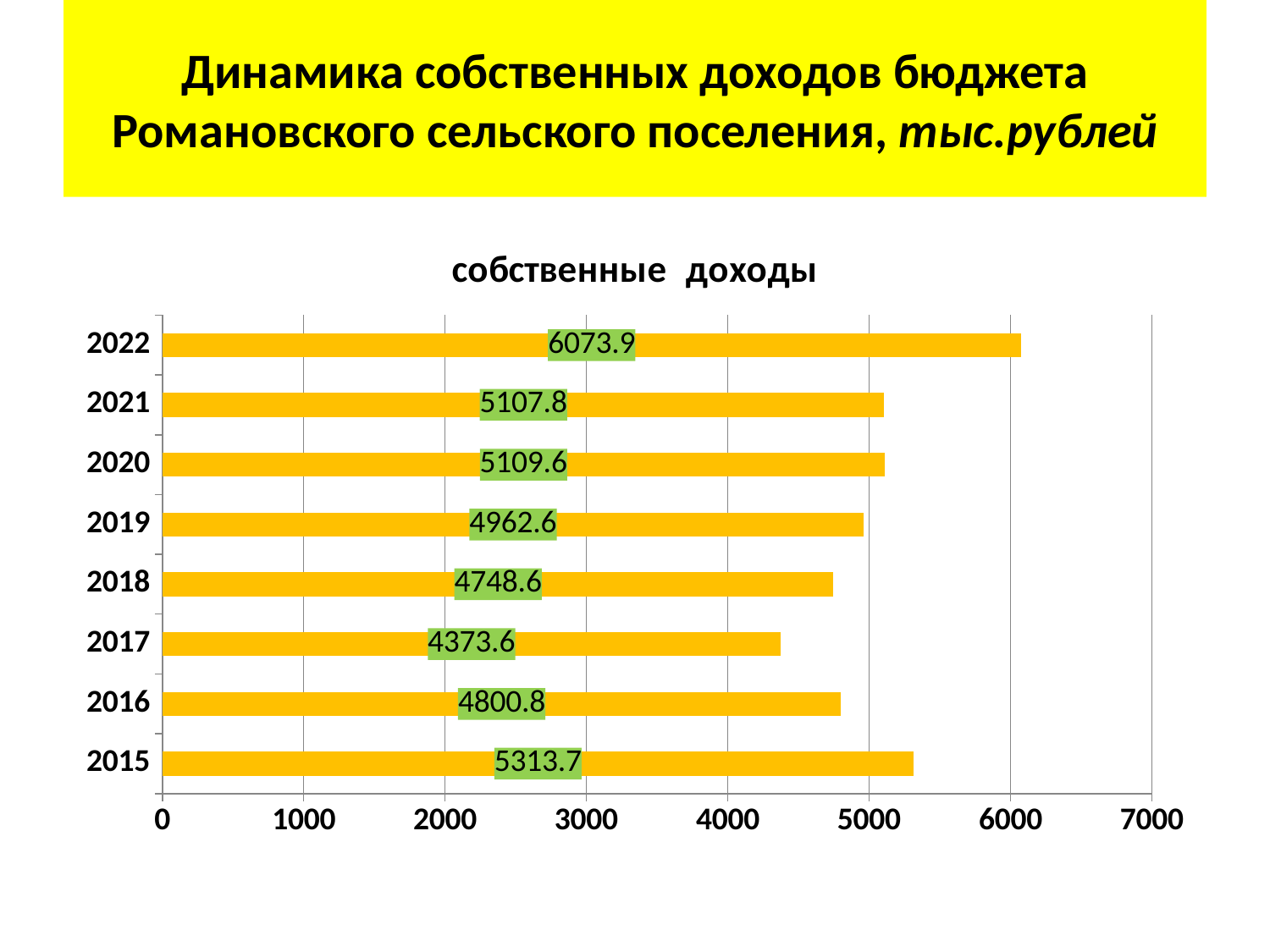
Which is larger, the value for 2015 or the value for 2019? 2015 What is the value for 2017? 4373.6 What is the difference between the values for 2022 and 2021? 966.1 Is the value for 2017 greater or less than 5000? less What is the value for 2019? 4962.6 Which year has the highest value? 2022 How many years are shown in the chart? 8 What kind of chart is shown on the slide? bar chart What is the value for 2015? 5313.7 What is the value for 2022? 6073.9 Which year has the lowest value? 2017 What is the difference between the values for 2015 and 2016? 512.9